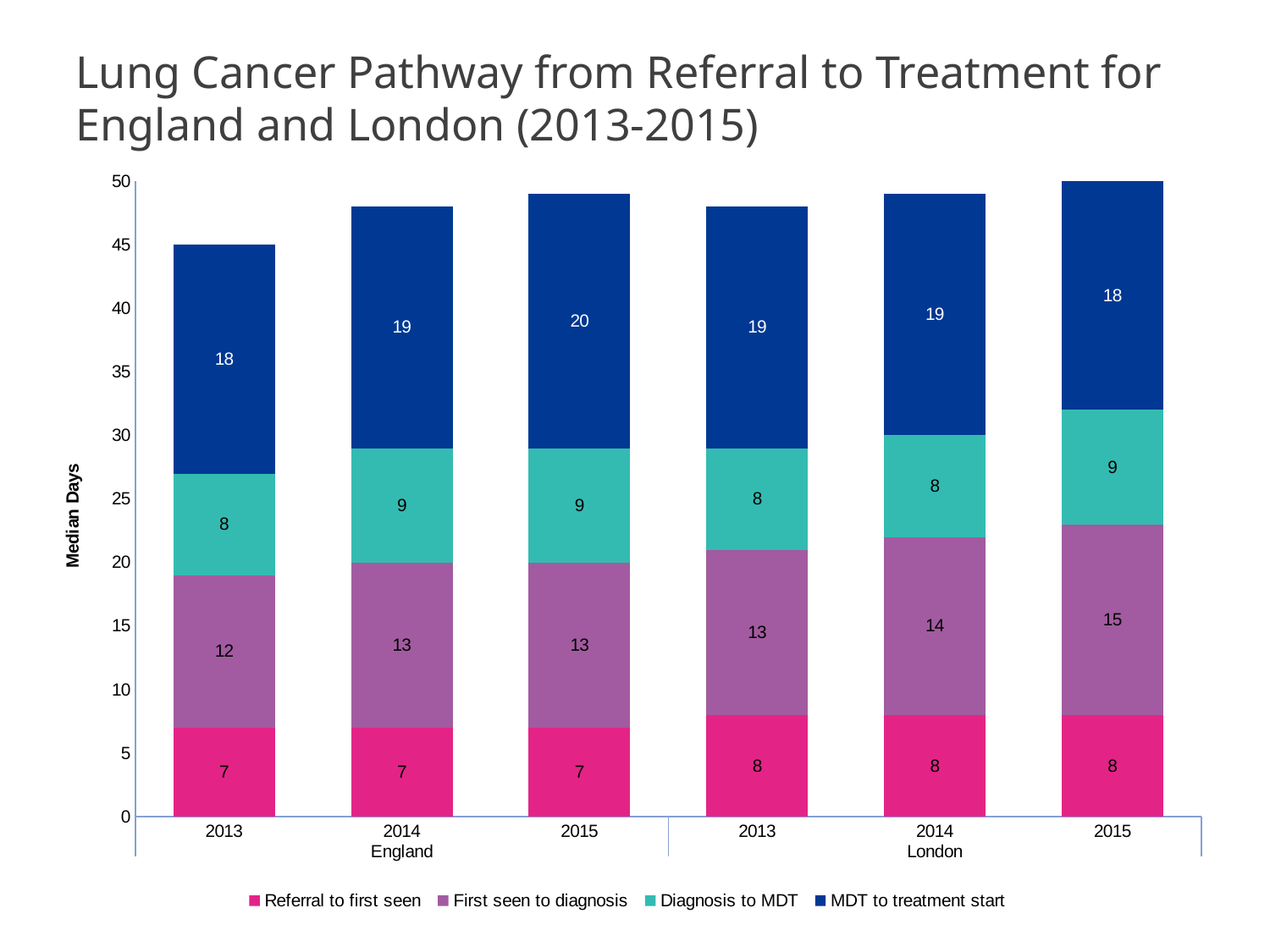
What is the total of the stacked bar for London in 2015? 50 What kind of chart is shown on the slide? Stacked bar chart Which bar has the lowest 'First seen to diagnosis' value? England 2013 What is the value for 'Referral to first seen' for England in 2013? 7 How many series does the legend list? 4 Is the 'Referral to first seen' value larger for England 2014 or London 2014? London 2014 What is the difference between the 'First seen to diagnosis' values for London 2015 and England 2013? 3 What is the value for 'First seen to diagnosis' for London in 2015? 15 What is the label of the vertical axis? Median Days Which bar has the highest 'MDT to treatment start' value? England 2015 What is the value for 'MDT to treatment start' for England in 2015? 20 What is the total of the stacked bar for England in 2013? 45